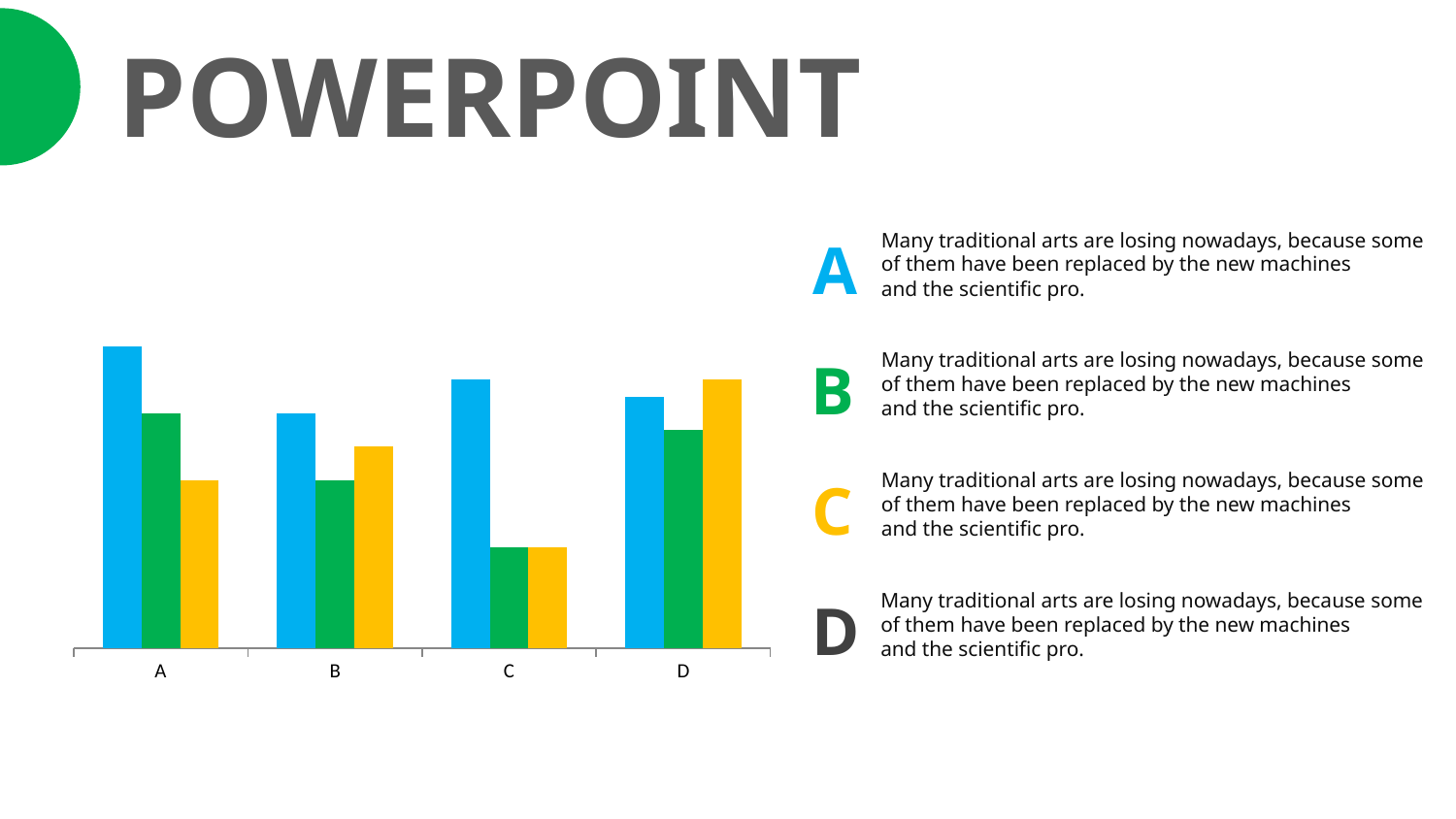
In category A, which is taller: the blue bar or the yellow bar? Blue What colours are the three bars in each category of the chart? Blue, green and yellow How many categories are shown on the x axis of the chart? 4 What are the category labels on the x axis of the chart? A, B, C, D Which category has the shortest green bar? C Which category has the tallest blue bar? A What kind of chart is shown on the slide? Bar chart Which is taller: the yellow bar in category A or the yellow bar in category D? D Which category has the shortest blue bar? B How many bars are plotted for each category in the chart? 3 Which category has the tallest yellow bar? D In category B, which is taller: the blue bar or the green bar? Blue